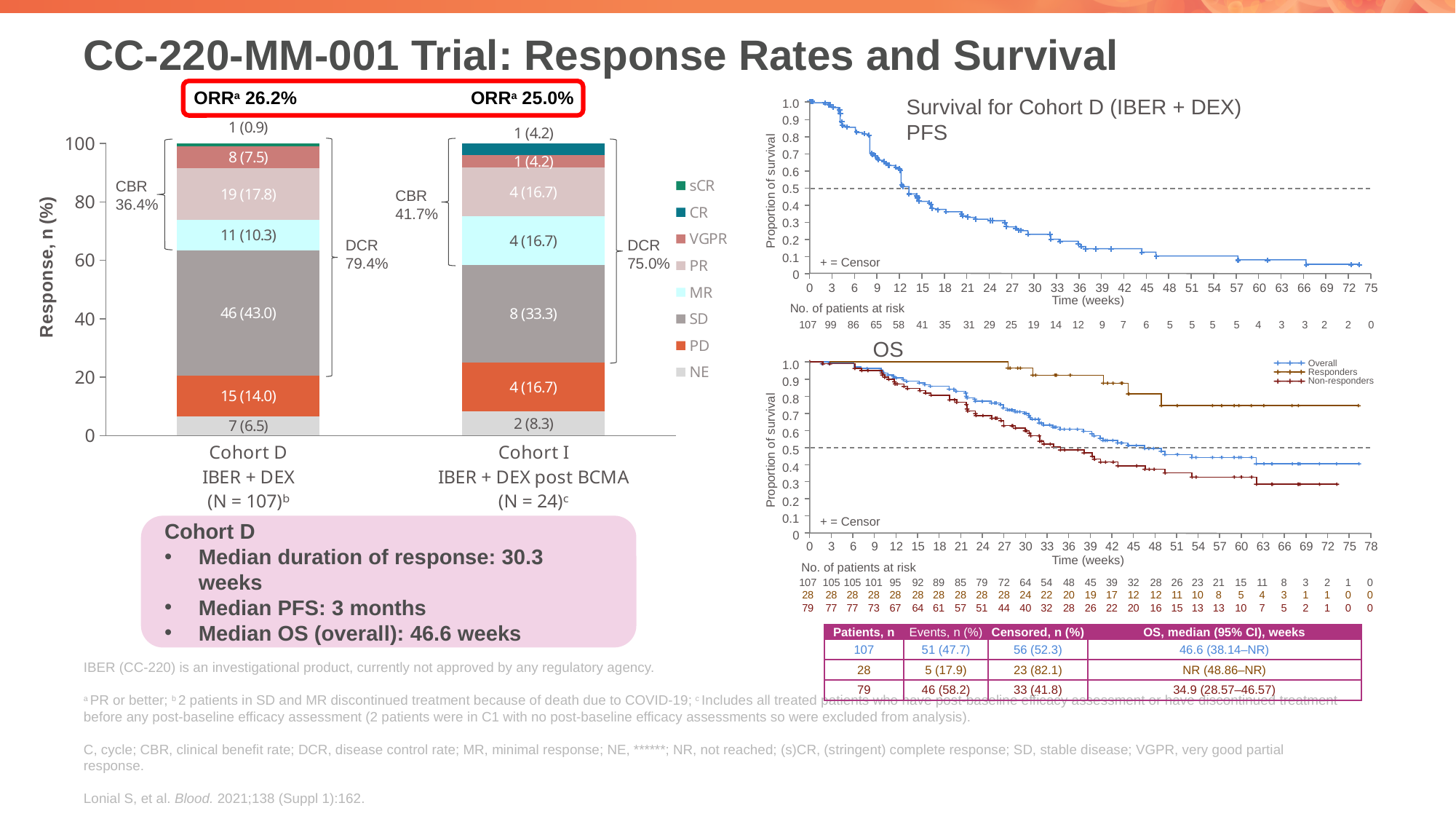
In the response rate bar chart, which response category is the largest segment of the Cohort D bar? SD In the response rate bar chart, which cohort has the higher DCR, Cohort D or Cohort I? Cohort D In the response rate bar chart, what is the CBR for Cohort I? 41.7% In the response rate bar chart, how many patients in Cohort D had stable disease (SD)? 46 (43.0) What kind of chart is used to show the response rates for Cohort D and Cohort I? Stacked bar chart How many series does the legend of the OS survival chart list? 3 In the OS table below the OS survival chart, what is the median OS (95% CI) in weeks for the 107 patients? 46.6 (38.14–NR) In the PFS survival chart for Cohort D, how many patients were at risk at week 0? 107 In the response rate bar chart, how many more patients had SD in Cohort D than in Cohort I? 38 In the response rate bar chart, what is the ORR for Cohort D? 26.2% In the response rate bar chart, what is the value for PD in Cohort I? 4 (16.7) How many response categories does the legend of the response rate bar chart list? 8